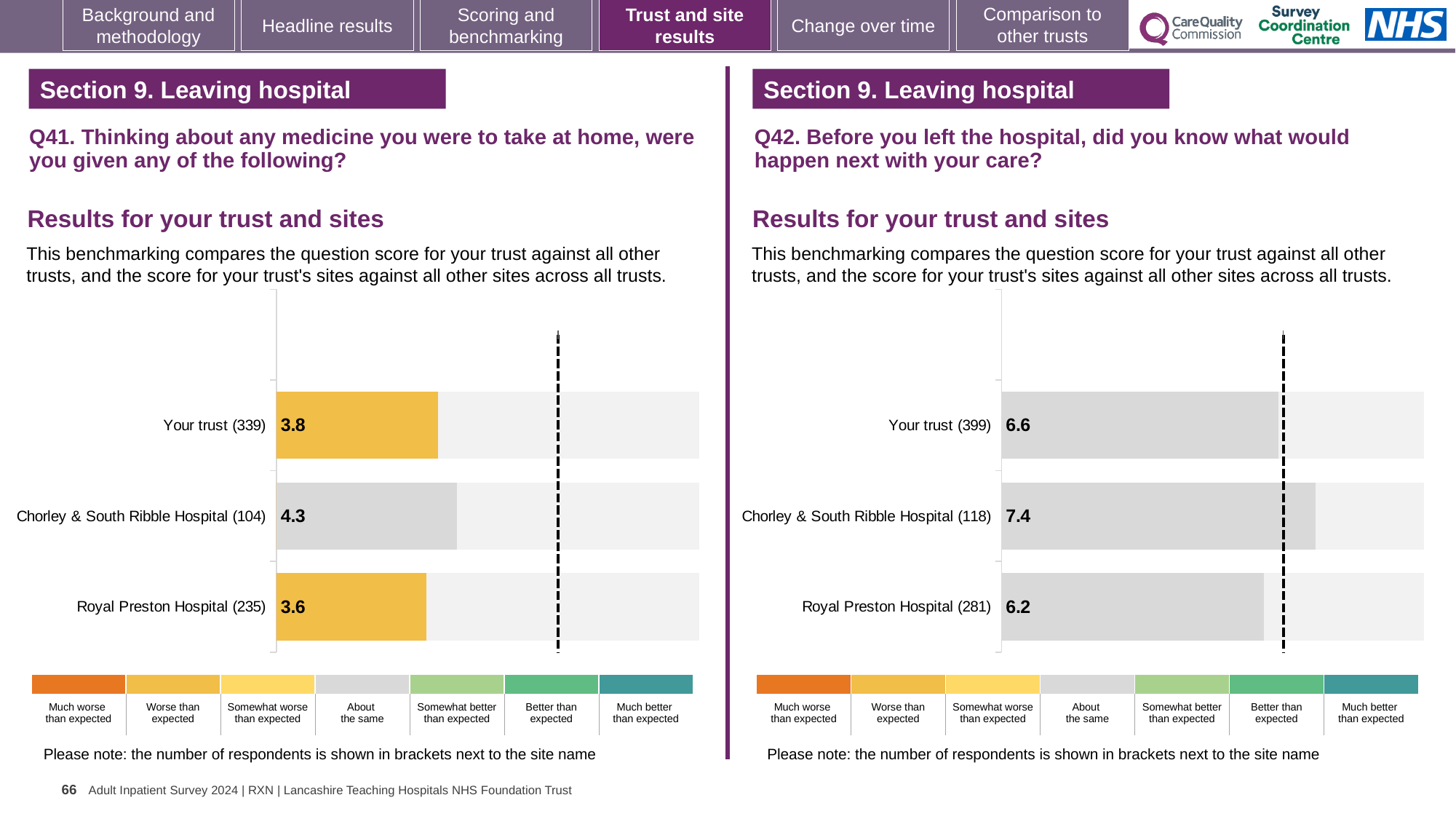
In the Q42 chart, what is the score for Chorley & South Ribble Hospital? 7.4 In the Q42 chart, what is the difference between the scores for Chorley & South Ribble Hospital and Royal Preston Hospital? 1.2 In the Q41 chart, which site or trust has the highest score? Chorley & South Ribble Hospital In the Q42 chart, what is the score for Royal Preston Hospital? 6.2 In the Q41 chart, how many respondents are shown in brackets for Royal Preston Hospital? 235 In the Q41 chart, what is the score for Royal Preston Hospital? 3.6 In the Q42 chart, what is the score for Your trust? 6.6 In the Q41 chart, what is the score for Chorley & South Ribble Hospital? 4.3 How many bars are plotted in the Q42 chart? 3 In the Q41 chart, what is the score for Your trust? 3.8 In the Q41 chart, which has the larger score, Your trust or Royal Preston Hospital? Your trust In the Q42 chart, which site or trust has the lowest score? Royal Preston Hospital